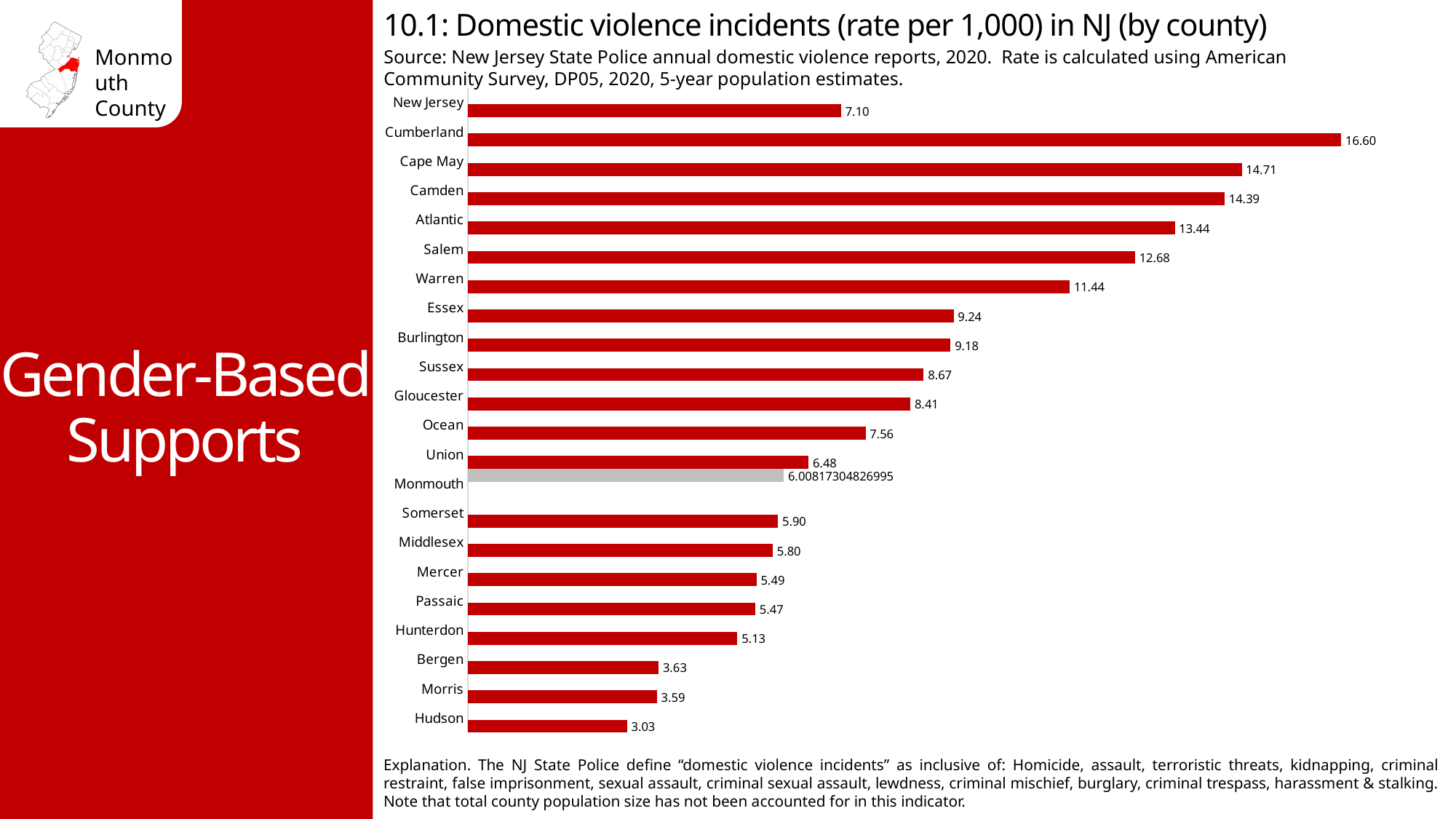
Which county has the highest domestic violence incident rate per 1,000? Cumberland Which has a higher domestic violence incident rate, Essex or Ocean? Essex What is the difference between the rates for Cape May and Camden? 0.32 Which county has the lowest domestic violence incident rate per 1,000? Hudson What is the difference between the rates for Cumberland and Hudson? 13.57 What is the domestic violence incident rate per 1,000 shown for New Jersey overall? 7.10 How many bars (categories) are plotted in the chart? 22 What is the domestic violence incident rate per 1,000 for Cumberland county? 16.60 What value is labelled on the Monmouth bar? 6.00817304826995 What type of chart is used to show the domestic violence incident rates? Bar chart Which bar is coloured grey instead of red? Monmouth Which has a higher domestic violence incident rate, Bergen or Hunterdon? Hunterdon